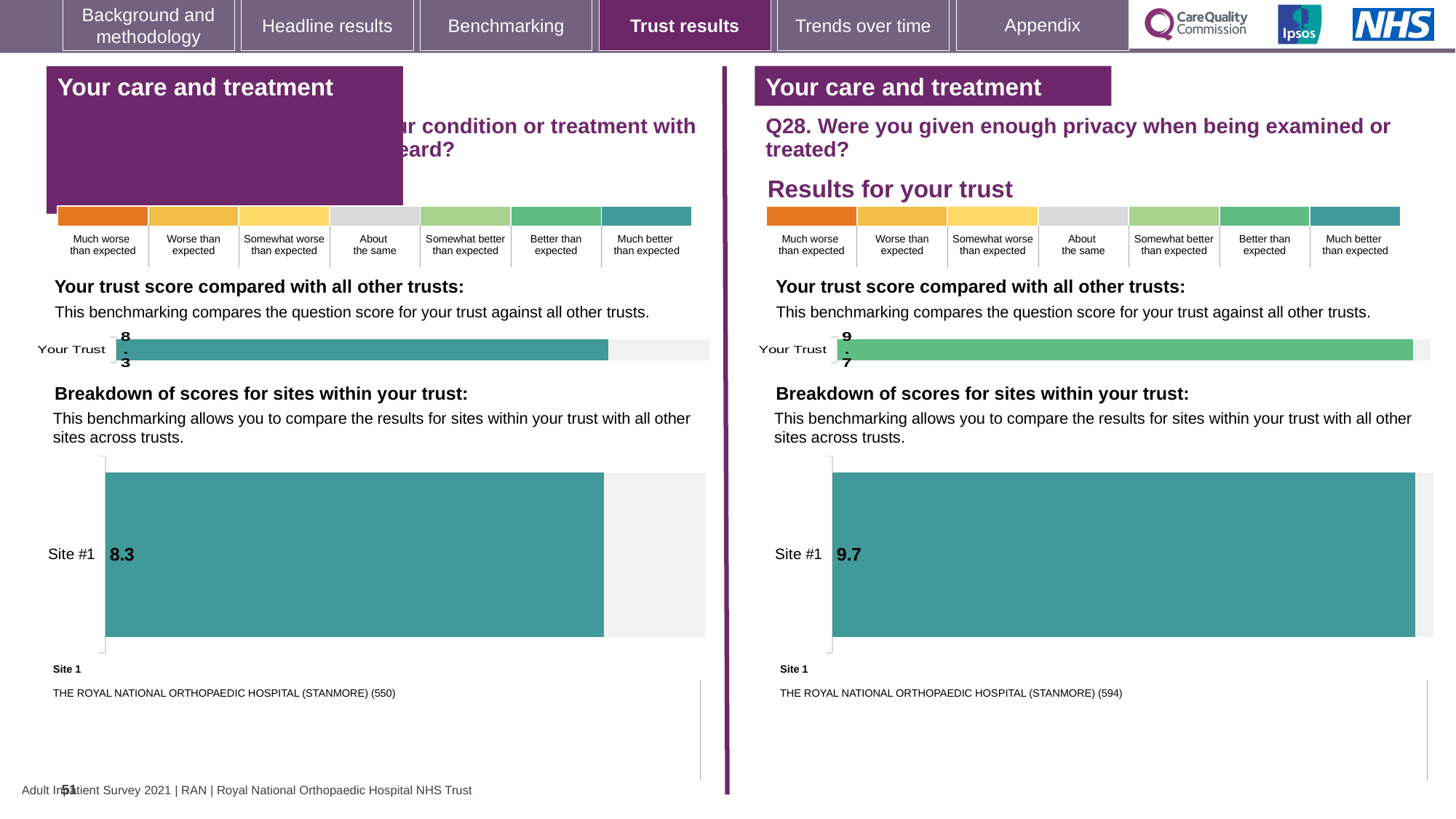
How many sites are shown in the breakdown of scores for sites chart on the left-hand panel? 1 What type of chart is used to show the Site #1 score on the right-hand panel (Q28)? Bar chart On the right-hand panel (Q28), what score is shown for Site #1 in the breakdown of scores for sites chart? 9.7 Which is larger: the Your Trust score on the left-hand panel or the Your Trust score on the right-hand panel (Q28)? Right-hand panel (Q28) Is the Your Trust score on the left-hand panel the same as the Site #1 score on the left-hand panel? Yes On the right-hand panel (Q28, privacy when being examined or treated), what is the score shown for Your Trust in the trust comparison bar chart? 9.7 On the left-hand panel, what score is shown for Site #1 in the breakdown of scores for sites chart? 8.3 What is the difference between the Site #1 score on the right-hand panel (Q28) and the Site #1 score on the left-hand panel? 1.4 On the left-hand panel, what is the score shown for Your Trust in the trust comparison bar chart? 8.3 On the left-hand panel, what colour is the Site #1 bar in the breakdown of scores for sites chart? Teal On the right-hand panel (Q28), what colour is the Your Trust bar in the trust comparison chart? Green How many sites are shown in the breakdown of scores for sites chart on the right-hand panel (Q28)? 1